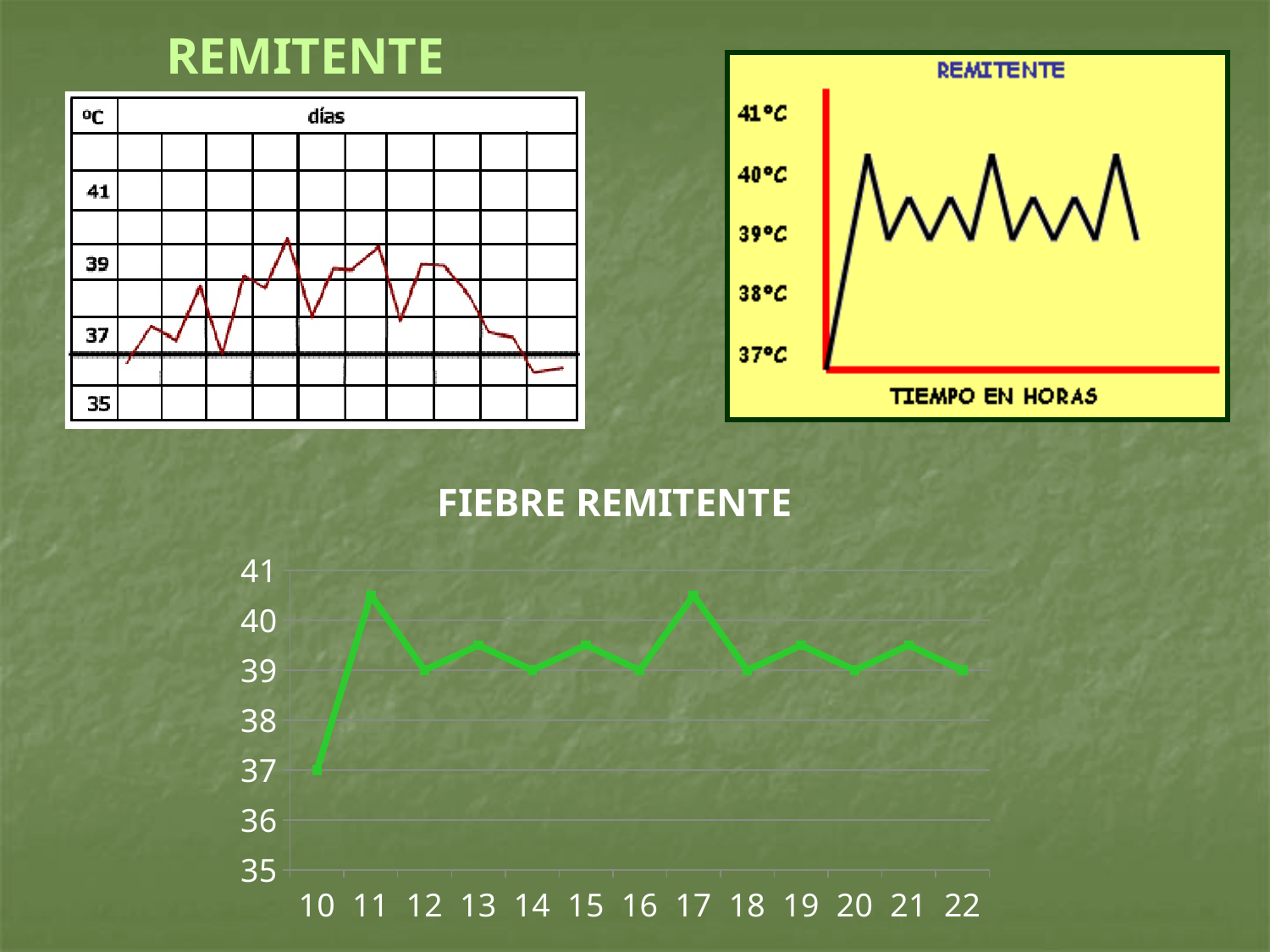
In the bottom chart FIEBRE REMITENTE, what is the value at 22? 39 What kind of chart is the bottom chart titled FIEBRE REMITENTE? line chart In the bottom chart FIEBRE REMITENTE, what is the difference between the value at 12 and the value at 10? 2 In the bottom chart FIEBRE REMITENTE, is the value at 13 greater or less than 40? less In the bottom chart FIEBRE REMITENTE, what is the value at 12? 39 In the bottom chart FIEBRE REMITENTE, at which x-axis point is the value lowest? 10 How many data points are plotted in the bottom chart FIEBRE REMITENTE? 13 In the bottom chart FIEBRE REMITENTE, which is larger, the value at 11 or the value at 12? 11 In the bottom chart FIEBRE REMITENTE, what is the value at 10? 37 In the bottom chart FIEBRE REMITENTE, is the value at 11 greater or less than 40? greater What is the x-axis label of the yellow chart at the top right titled REMITENTE? TIEMPO EN HORAS In the bottom chart FIEBRE REMITENTE, does the value rise or fall from 10 to 11? rise